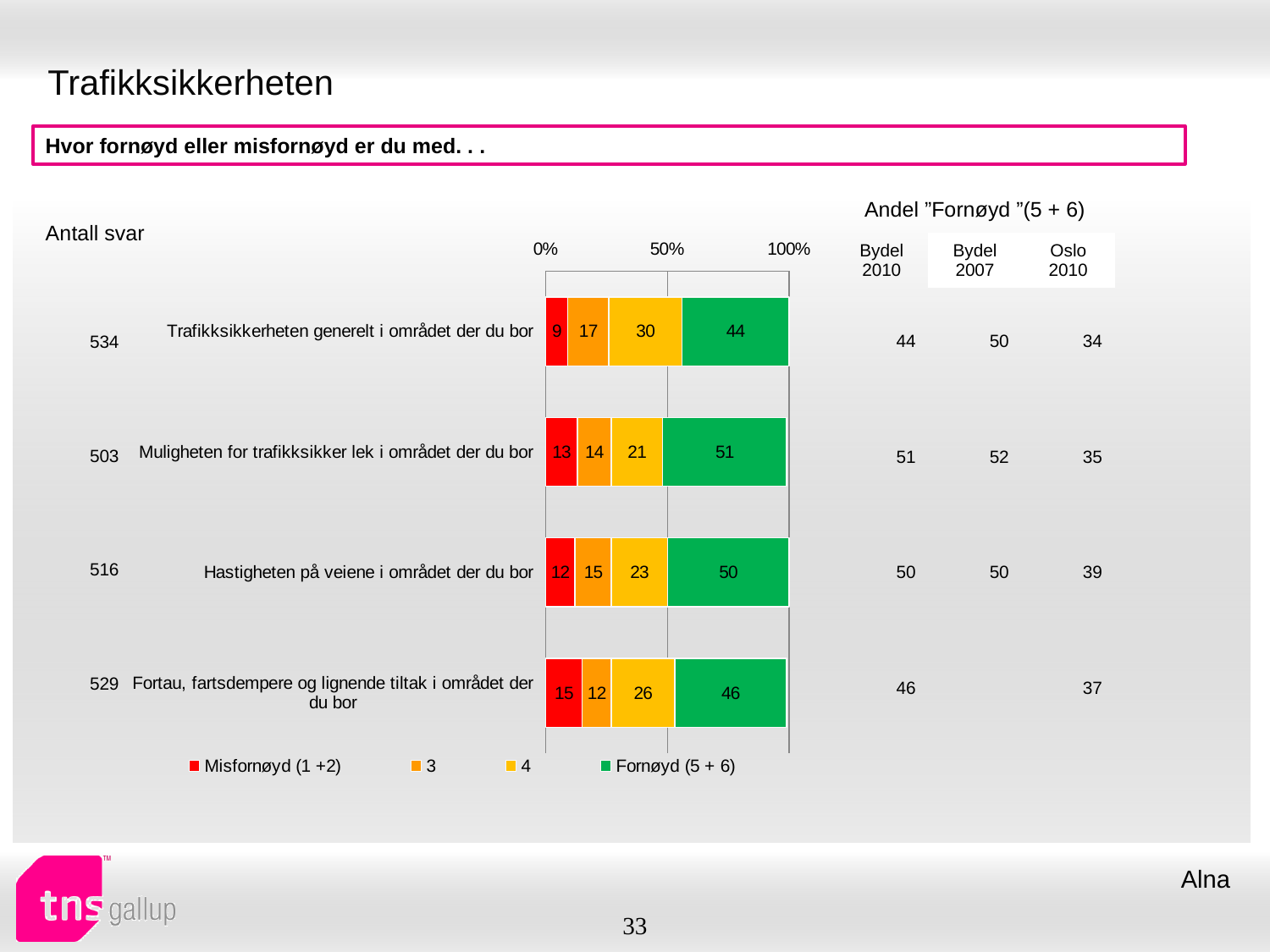
How many series does the chart legend list? 4 How many categories are plotted in the chart? 4 What colour represents the Fornøyd (5 + 6) series in the chart? Green Which is larger: the "3" segment for "Trafikksikkerheten generelt i området der du bor" or the "3" segment for "Fortau, fartsdempere og lignende tiltak i området der du bor"? Trafikksikkerheten generelt i området der du bor What is the total of the stacked bar for "Hastigheten på veiene i området der du bor"? 100 Which category has the highest Fornøyd (5 + 6) value? Muligheten for trafikksikker lek i området der du bor What is the difference between the Fornøyd (5 + 6) values for "Muligheten for trafikksikker lek i området der du bor" and "Trafikksikkerheten generelt i området der du bor"? 7 What is the value of the Misfornøyd (1 +2) segment for "Fortau, fartsdempere og lignende tiltak i området der du bor"? 15 What is the value of the Fornøyd (5 + 6) segment for "Trafikksikkerheten generelt i området der du bor"? 44 What kind of chart is shown on the slide? Stacked bar chart Which category has the lowest Misfornøyd (1 +2) value? Trafikksikkerheten generelt i området der du bor What is the value of the "4" segment for "Hastigheten på veiene i området der du bor"? 23